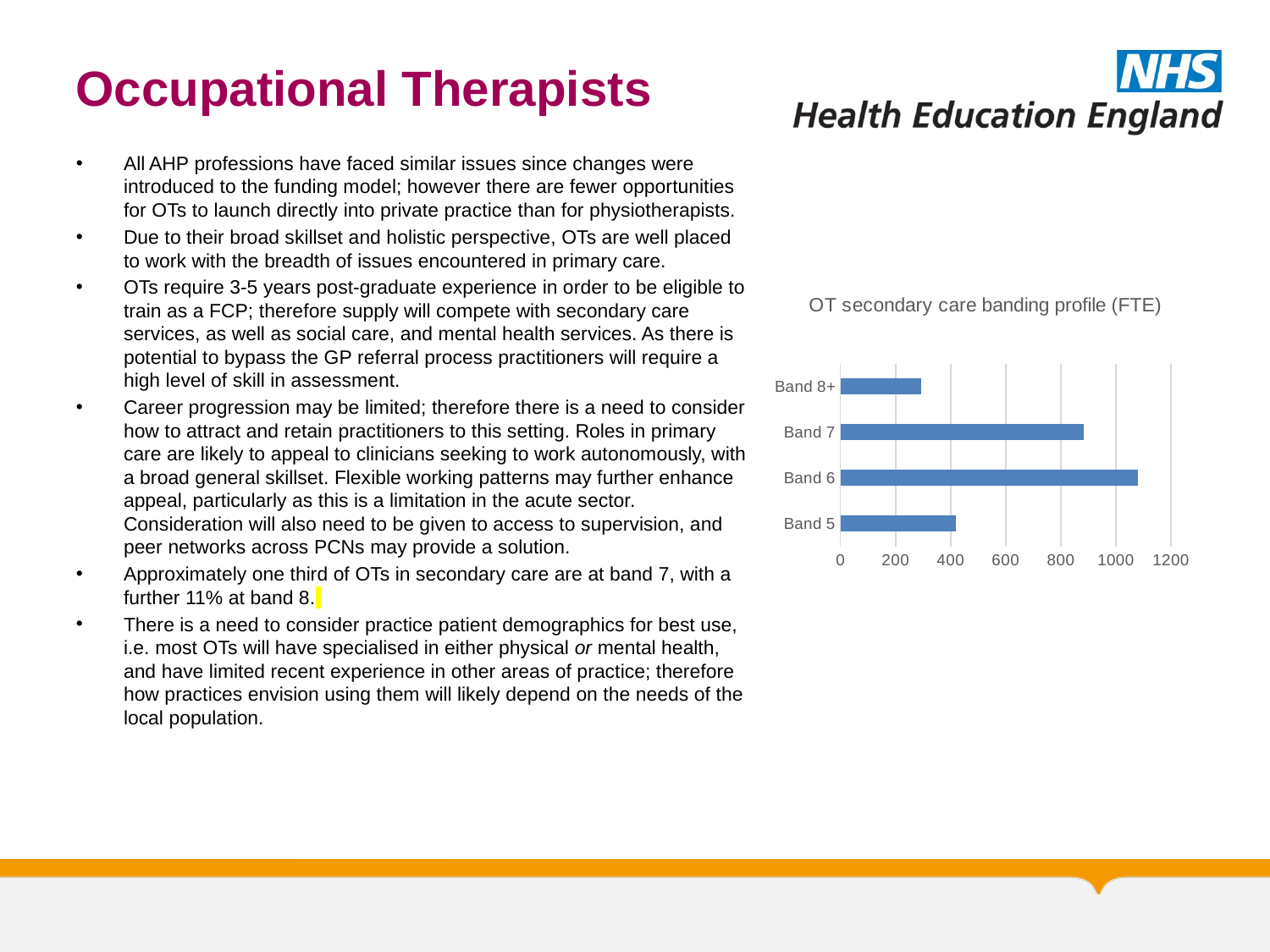
Which band has the highest value in the chart? Band 6 What is the title of the chart on the slide? OT secondary care banding profile (FTE) What is the highest value shown on the horizontal axis of the chart? 1200 Is the value for Band 8+ greater or less than 400? less Is the value for Band 5 greater or less than 600? less How many bands are shown in the chart? 4 Which band has the lowest value in the chart? Band 8+ Is the value for Band 6 greater or less than 1000? greater Which has a larger value, Band 5 or Band 8+? Band 5 What type of chart is shown on the slide? bar chart Which has a larger value, Band 7 or Band 5? Band 7